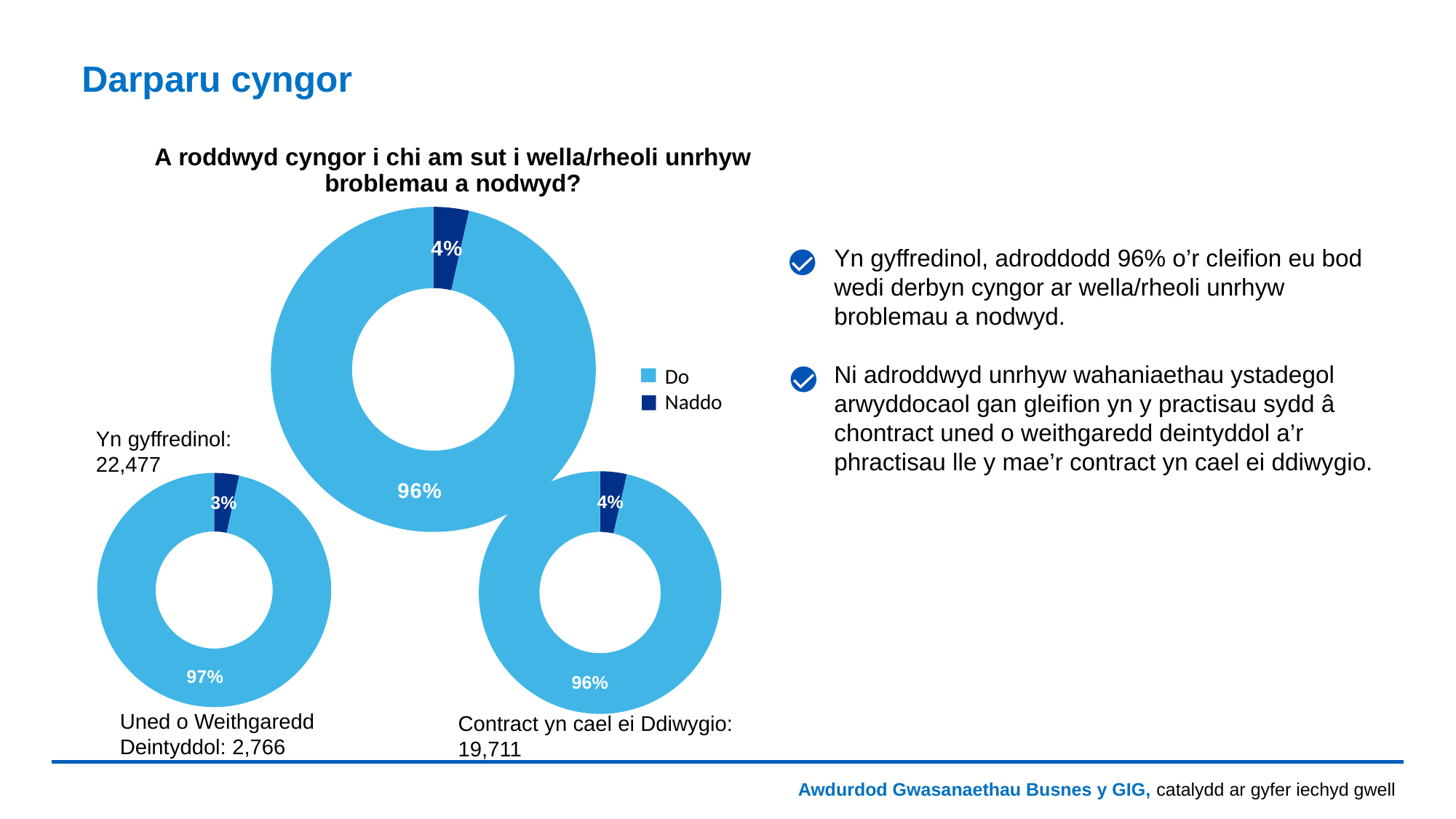
In the 'Uned o Weithgaredd Deintyddol: 2,766' doughnut chart, what percentage is shown for 'Do'? 97% In the 'Uned o Weithgaredd Deintyddol: 2,766' doughnut chart, which category has the largest share? Do In the large 'Yn gyffredinol: 22,477' doughnut chart, which category has the smallest share? Naddo Is the 'Do' share larger in the 'Uned o Weithgaredd Deintyddol: 2,766' chart or in the 'Contract yn cael ei Ddiwygio: 19,711' chart? Uned o Weithgaredd Deintyddol: 2,766 In the 'Contract yn cael ei Ddiwygio: 19,711' doughnut chart, what percentage is shown for 'Do'? 96% In the large 'Yn gyffredinol: 22,477' doughnut chart, what percentage is shown for 'Naddo'? 4% In the large 'Yn gyffredinol: 22,477' doughnut chart, what percentage is shown for 'Do'? 96% What type of chart is used to show the responses on this slide? Doughnut chart In the 'Contract yn cael ei Ddiwygio: 19,711' doughnut chart, what percentage is shown for 'Naddo'? 4% In the 'Uned o Weithgaredd Deintyddol: 2,766' doughnut chart, what percentage is shown for 'Naddo'? 3% In the 'Uned o Weithgaredd Deintyddol: 2,766' doughnut chart, what is the difference in percentage points between 'Do' and 'Naddo'? 94 How many entries does the shared legend list for the doughnut charts? 2